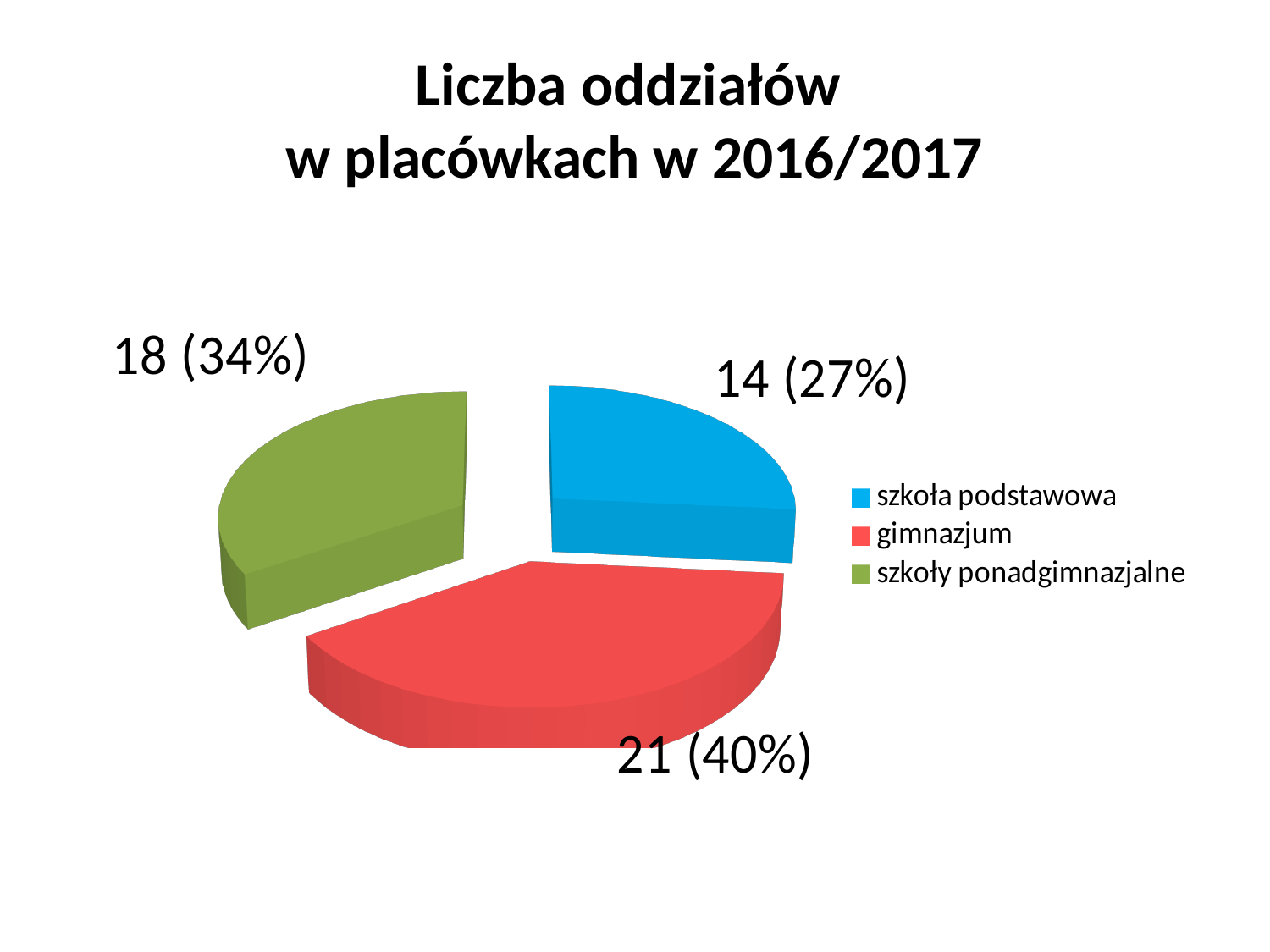
What kind of chart is shown on the slide? pie chart What is the value for szkoły ponadgimnazjalne? 18 Which category has the largest slice? gimnazjum What is the value for gimnazjum? 21 What is the difference between the values for gimnazjum and szkoła podstawowa? 7 How many slices does the pie chart have? 3 What is the title of the chart? Liczba oddziałów w placówkach w 2016/2017 Which category has the smallest slice? szkoła podstawowa What share of the pie does szkoła podstawowa represent? 27% What share of the pie does gimnazjum represent? 40% What is the value for szkoła podstawowa? 14 How many entries does the legend list? 3